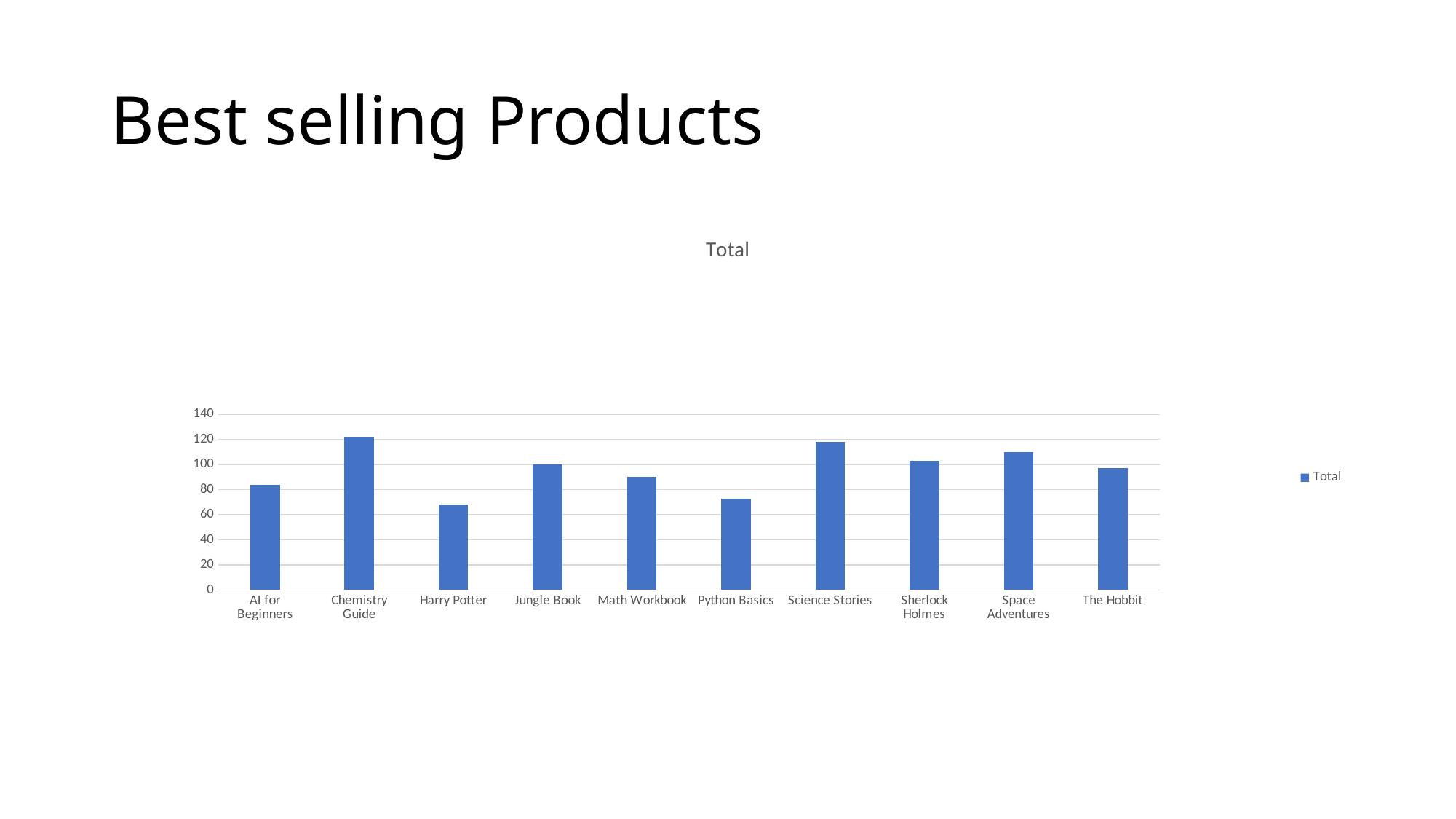
Is the value for Python Basics greater or less than 80? less Which product has the highest bar in the chart? Chemistry Guide How many products are shown on the x axis of the chart? 10 Which has the larger value, Space Adventures or Math Workbook? Space Adventures What is the title shown above the chart? Total What kind of chart is shown on the slide? Bar chart Which product has the lowest bar in the chart? Harry Potter Is the value for Science Stories greater or less than 100? greater Is the value for Space Adventures greater or less than 100? greater How many series does the chart's legend list? 1 Which has the larger value, Chemistry Guide or Harry Potter? Chemistry Guide